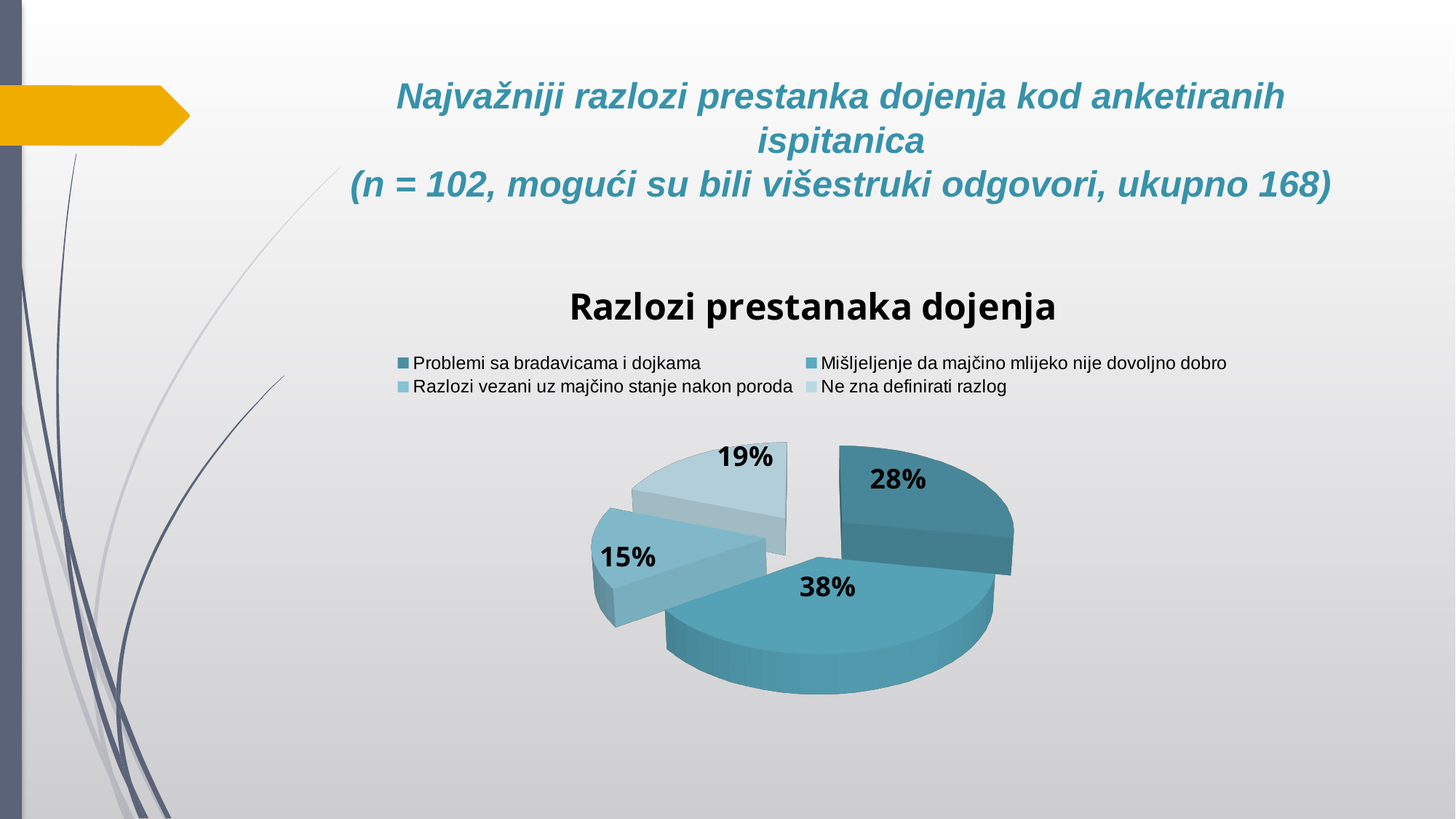
What kind of chart is shown on the slide? pie chart How many slices does the pie chart have? 4 What is the chart's title? Razlozi prestanaka dojenja What is the difference in percentage points between the largest slice (38%) and the 'Problemi sa bradavicama i dojkama' slice (28%)? 10 What share of the pie is 'Problemi sa bradavicama i dojkama'? 28% Which category has the smallest slice of the pie? Razlozi vezani uz majčino stanje nakon poroda What share of the pie is 'Ne zna definirati razlog'? 19% How many entries does the legend list? 4 Which is larger: the share for 'Ne zna definirati razlog' or the share for 'Razlozi vezani uz majčino stanje nakon poroda'? Ne zna definirati razlog Which category has the largest slice of the pie? Mišljeljenje da majčino mlijeko nije dovoljno dobro What share of the pie is 'Mišljeljenje da majčino mlijeko nije dovoljno dobro'? 38%